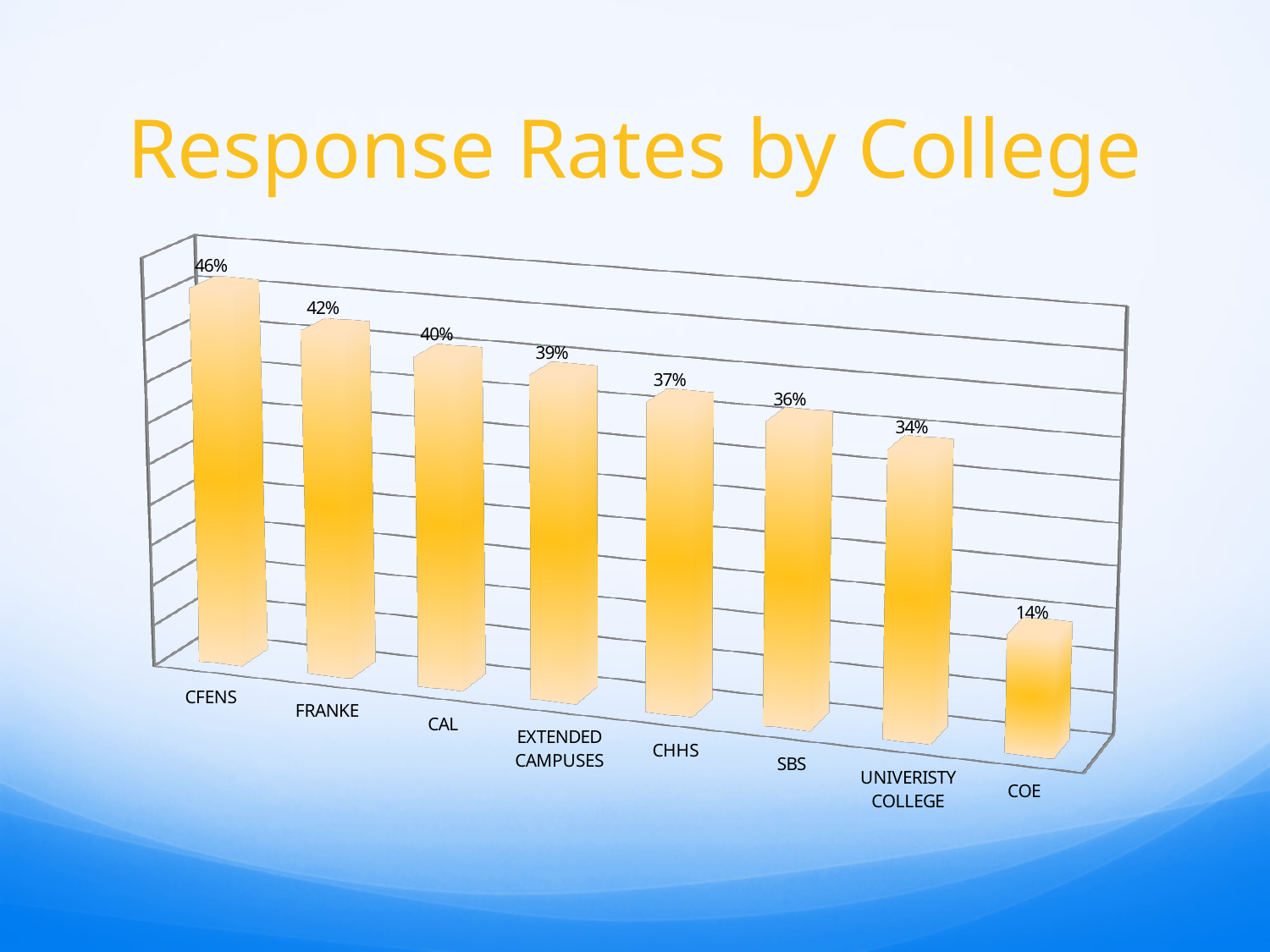
What is the difference between the response rates of CFENS and COE? 32% Which college has the lowest response rate? COE What is the response rate for COE? 14% Which has a higher response rate, CHHS or UNIVERISTY COLLEGE? CHHS What kind of chart is shown on the slide? Bar chart What is the response rate for CFENS? 46% Which college has the highest response rate? CFENS What is the difference between the response rates of CAL and SBS? 4% How many colleges are shown in the chart? 8 What is the response rate for EXTENDED CAMPUSES? 39% Do the response rates rise or fall from left to right across the chart? Fall What is the response rate for FRANKE? 42%